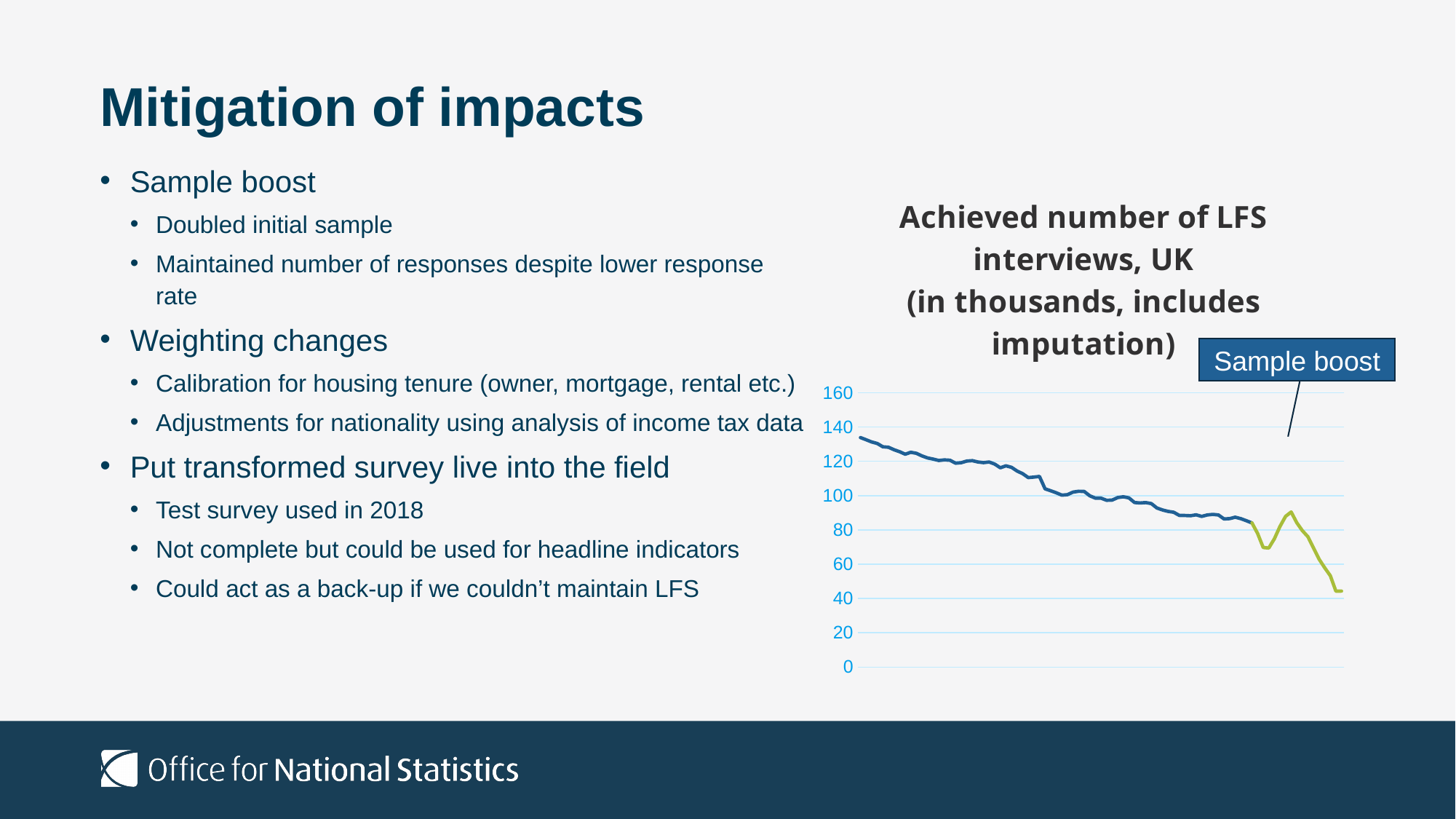
Is the value at the start (left end) of the line greater or less than 120? greater What kind of chart is shown on the slide? line chart Is the value at the end (right end) of the line greater or less than 60? less Is the highest point of the green 'Sample boost' segment greater or less than 80? greater What does the annotation box pointing to the green part of the line say? Sample boost What is the title of the chart? Achieved number of LFS interviews, UK (in thousands, includes imputation) Do the values in the chart generally rise or fall from left to right? fall Which end of the line is higher, the left end or the right end? left end